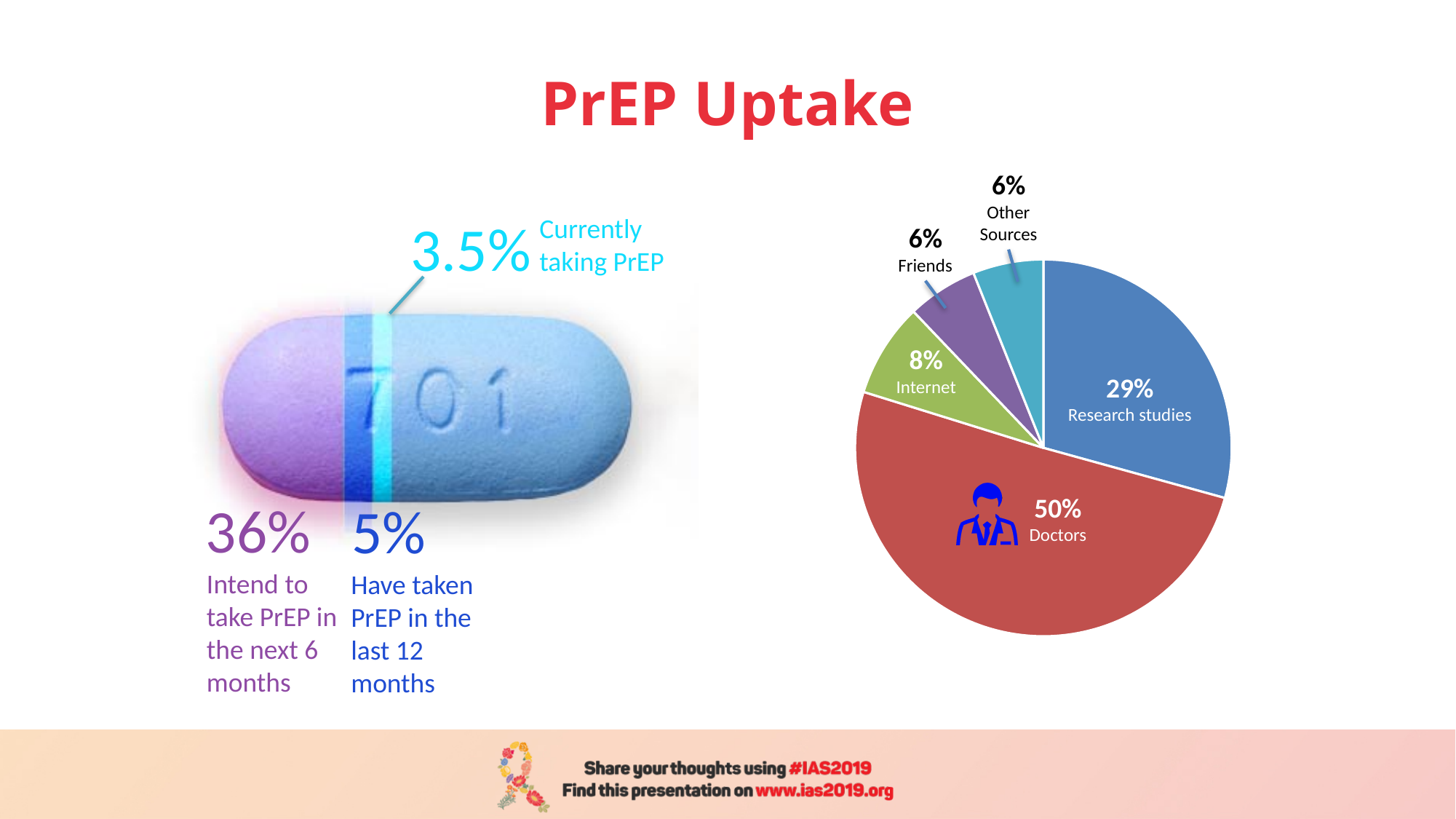
In the pie chart, what is the difference in percentage points between Doctors and Research studies? 21 In the pie chart, what percentage is shown for Friends? 6% What kind of chart is shown on the right side of the slide? pie chart In the pie chart, what percentage is shown for Other Sources? 6% In the pie chart, what percentage is shown for Internet? 8% In the pie chart, what percentage is shown for Doctors? 50% In the pie chart, which is larger, Research studies or Internet? Research studies In the pie chart, what percentage is shown for Research studies? 29% In the pie chart, which category has the largest slice? Doctors In the pie chart, what is the difference in percentage points between Internet and Friends? 2 How many slices does the pie chart have? 5 In the pie chart, what colour is the Doctors slice? red